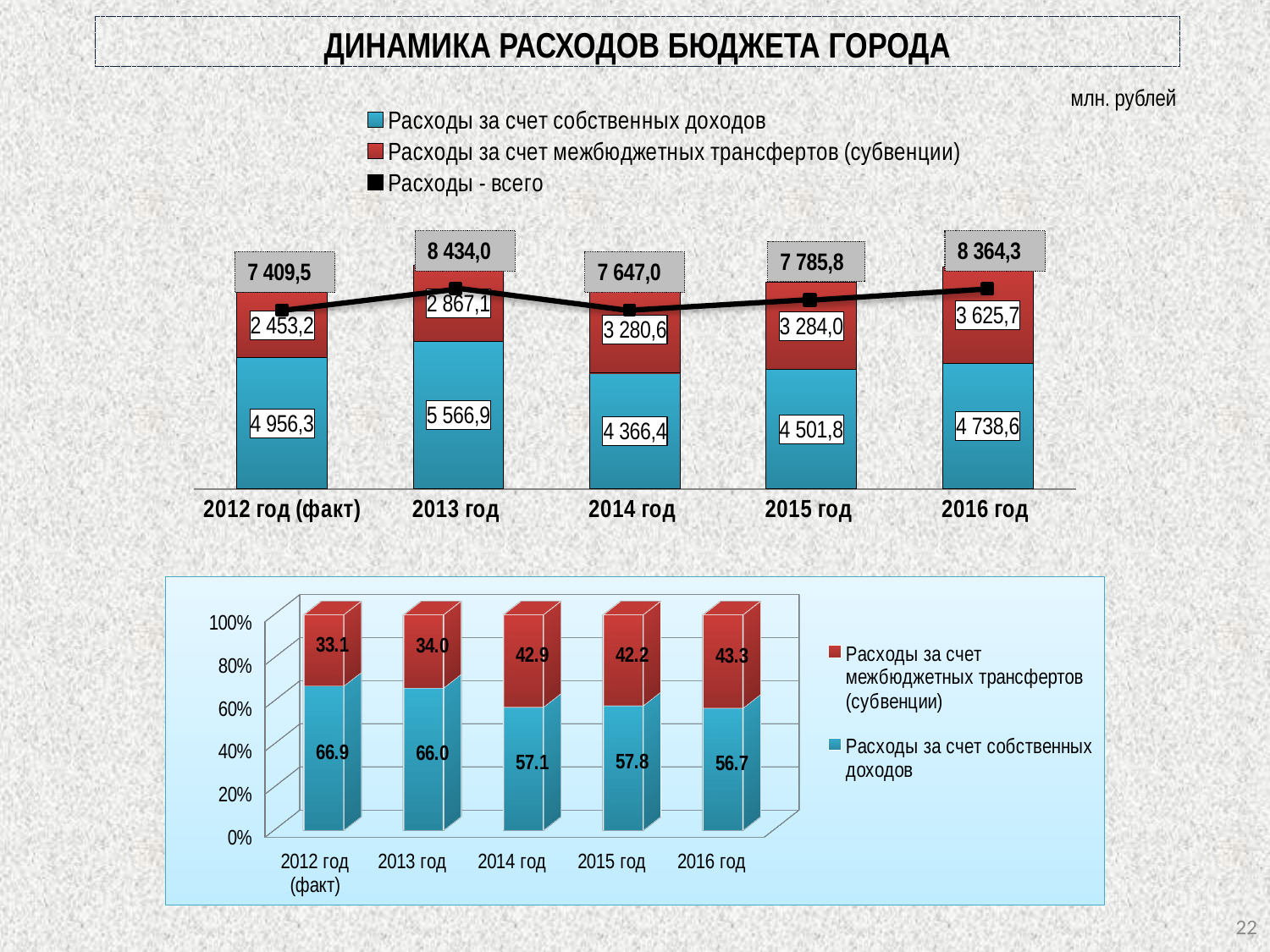
In the top chart, what is the value of 'Расходы за счет межбюджетных трансфертов (субвенции)' for 2016 год? 3 625,7 How many series does the legend of the top chart list? 3 In the bottom chart, what is the share of 'Расходы за счет собственных доходов' for 2016 год? 56.7 In the bottom chart, does the share of 'Расходы за счет собственных доходов' rise or fall from 2012 год (факт) to 2016 год? fall In the bottom chart, which year has the highest share of 'Расходы за счет межбюджетных трансфертов (субвенции)'? 2016 год In the top chart, what is the value of 'Расходы за счет собственных доходов' for 2013 год? 5 566,9 In the top chart, what is the difference between 'Расходы - всего' for 2016 год and 2015 год? 578,5 How many years are shown on the x axis of the bottom chart? 5 In the top chart, which year has the highest value of 'Расходы - всего'? 2013 год In the top chart, which is larger: 'Расходы за счет межбюджетных трансфертов (субвенции)' for 2012 год (факт) or for 2014 год? 2014 год In the top chart, which year has the lowest value of 'Расходы за счет собственных доходов'? 2014 год In the top chart, what is the value of 'Расходы - всего' for 2014 год? 7 647,0